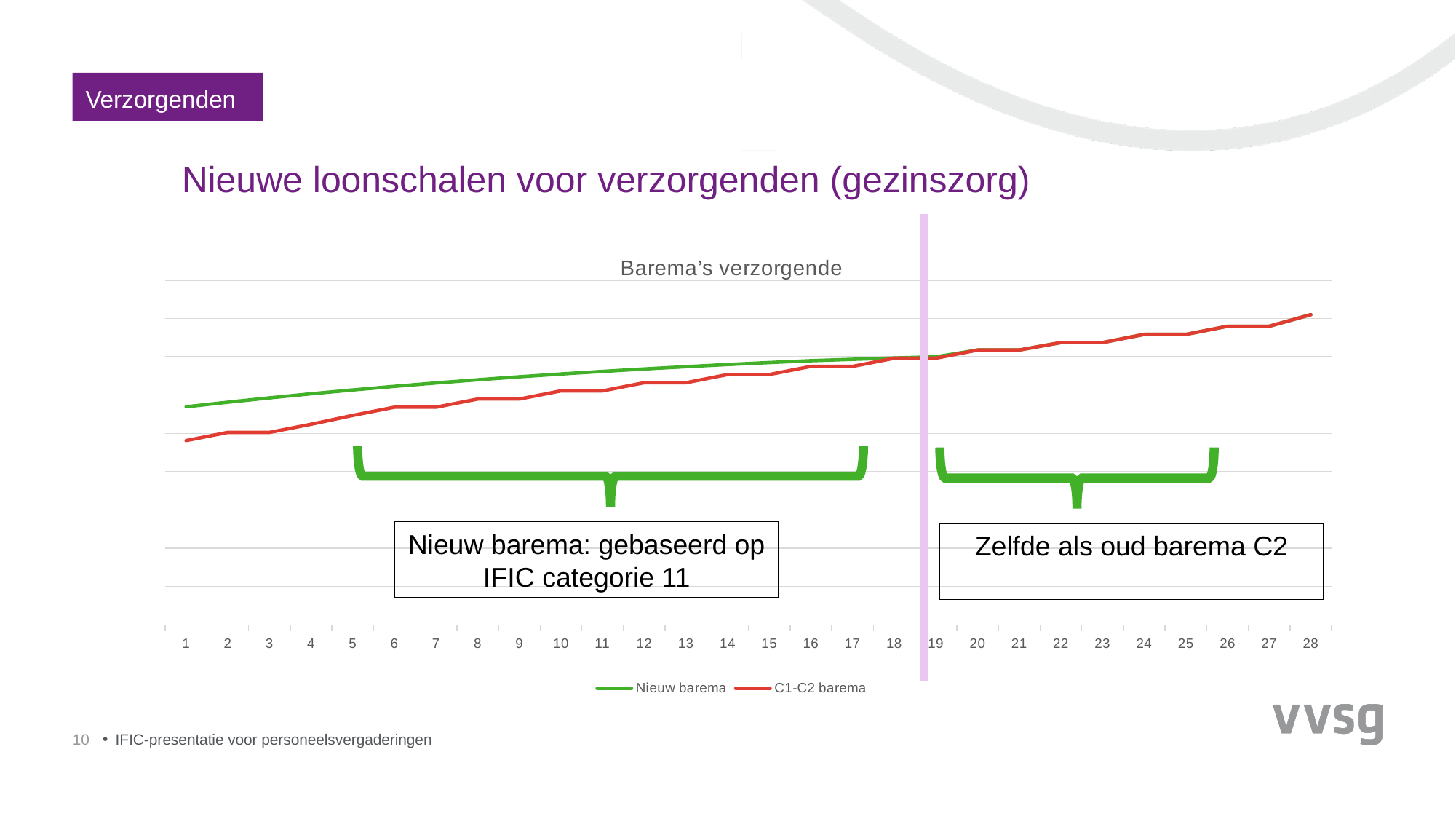
Do the values of the Nieuw barema series rise or fall along the x axis? rise Do the values of the C1-C2 barema series rise or fall along the x axis? rise What are the two series named in the legend? Nieuw barema and C1-C2 barema How many series does the legend list? 2 At x = 10, which series has the higher value, Nieuw barema or C1-C2 barema? Nieuw barema How many points are labelled along the x axis? 28 At x = 1, which series has the higher value, Nieuw barema or C1-C2 barema? Nieuw barema At which x value does the C1-C2 barema series have its lowest point? 1 What kind of chart is shown on the slide? line chart At which x value does the C1-C2 barema series reach its highest point? 28 What is the title of the chart? Barema's verzorgende